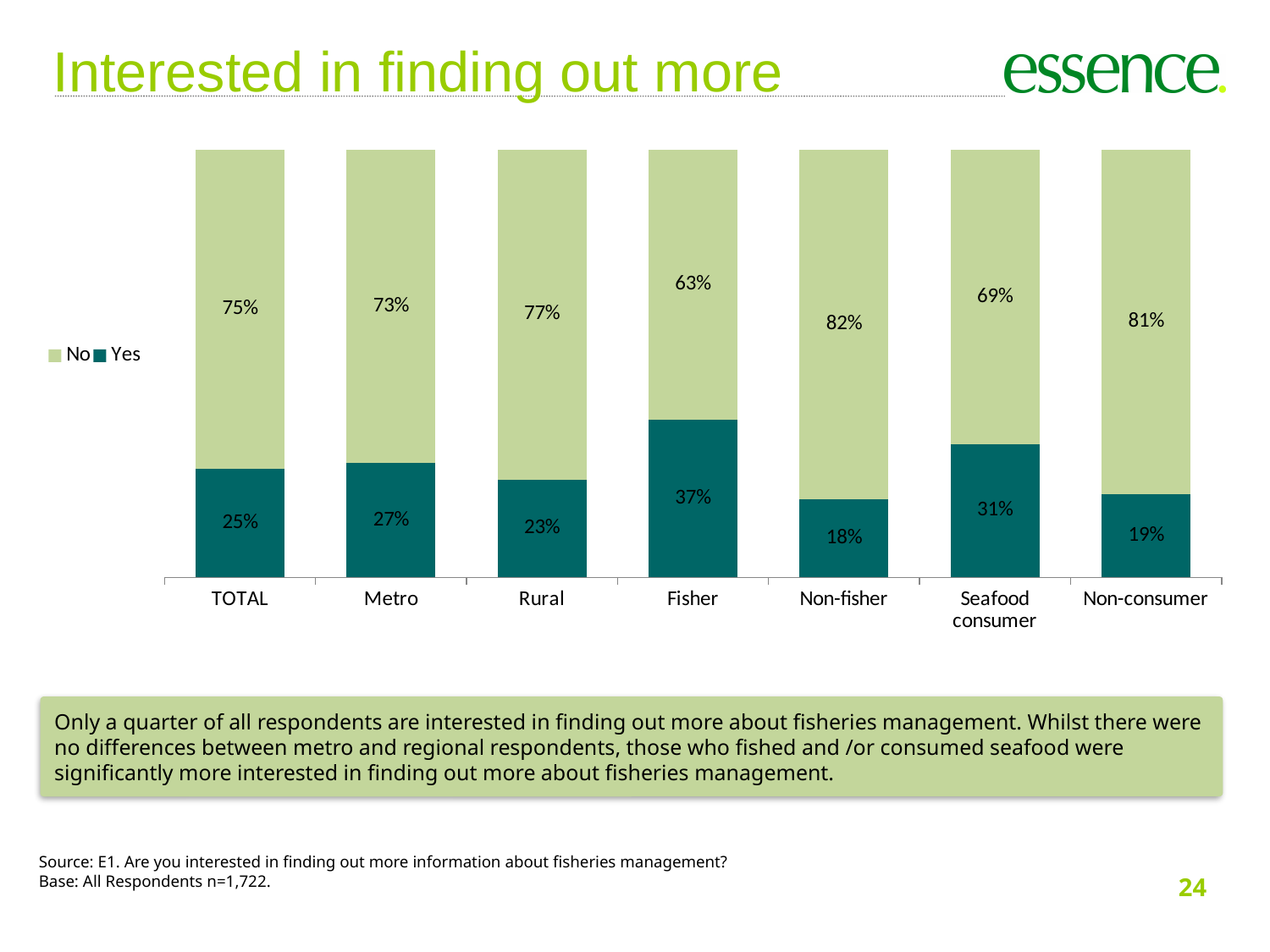
What are the two series listed in the legend? No and Yes Which category has the lowest Yes percentage? Non-fisher Which has a larger Yes percentage, Metro or Rural? Metro What kind of chart is shown on the slide? Stacked bar chart How many series does the legend list? 2 What percentage of Fisher respondents answered Yes? 37% Which category has the highest Yes percentage? Fisher What percentage of Non-fisher respondents answered No? 82% What is the total of the No and Yes values for the TOTAL bar? 100% What is the difference between the Yes percentages for Fisher and Non-fisher? 19 percentage points What is the Yes value for Seafood consumer? 31% How many categories are shown on the x axis? 7